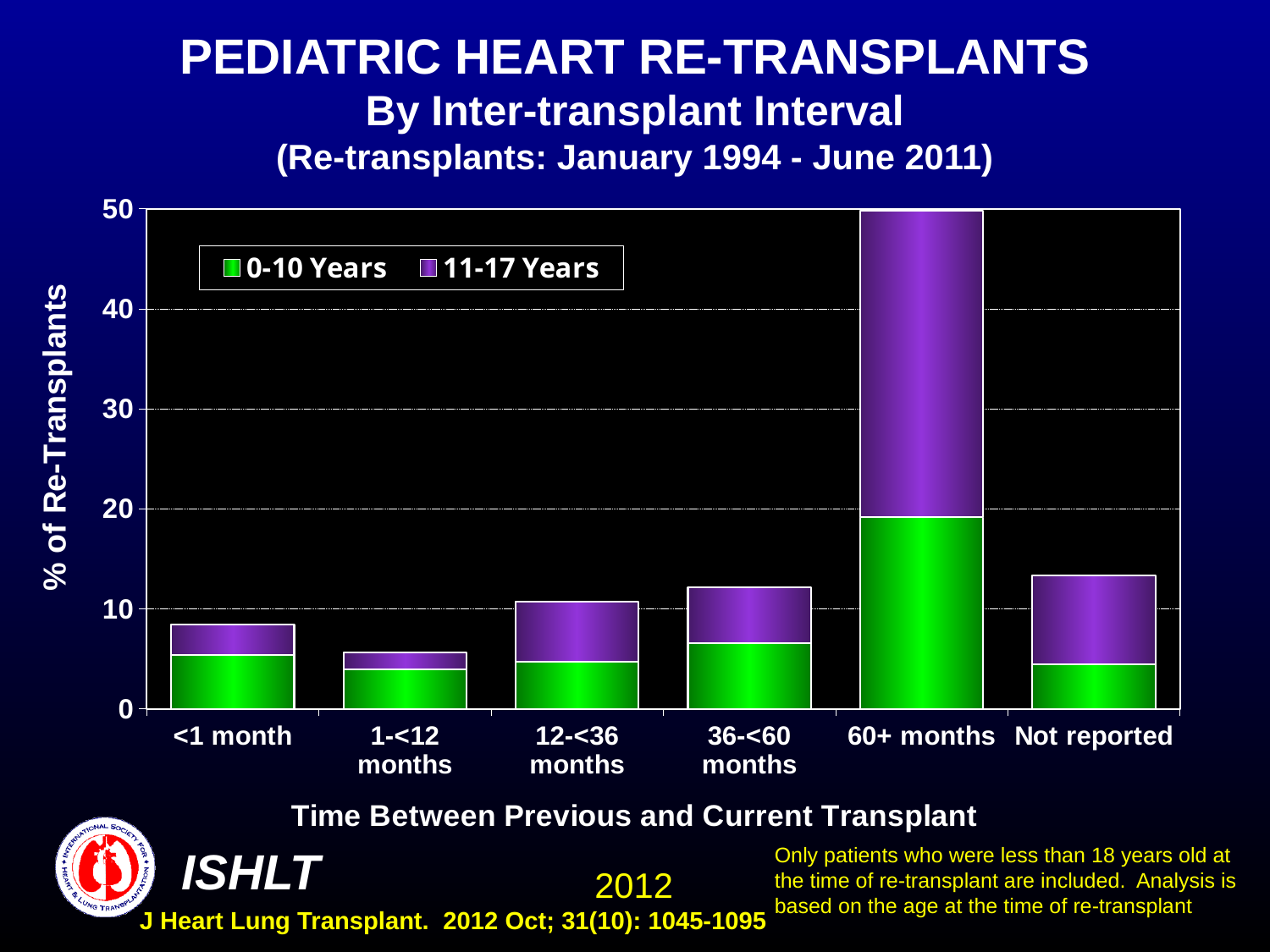
Is the total value for <1 month greater or less than 10? less How many inter-transplant interval categories are shown on the x axis? 6 What is the label of the y axis? % of Re-Transplants Which inter-transplant interval category has the lowest total % of re-transplants? 1-<12 months What kind of chart is shown on the slide? Stacked bar chart Which series is shown in purple in the legend? 11-17 Years Which has a larger total % of re-transplants, Not reported or <1 month? Not reported Which inter-transplant interval category has the highest total % of re-transplants? 60+ months Is the total value for 60+ months greater or less than 40? greater Is the total value for Not reported greater or less than 10? greater How many series does the legend list? 2